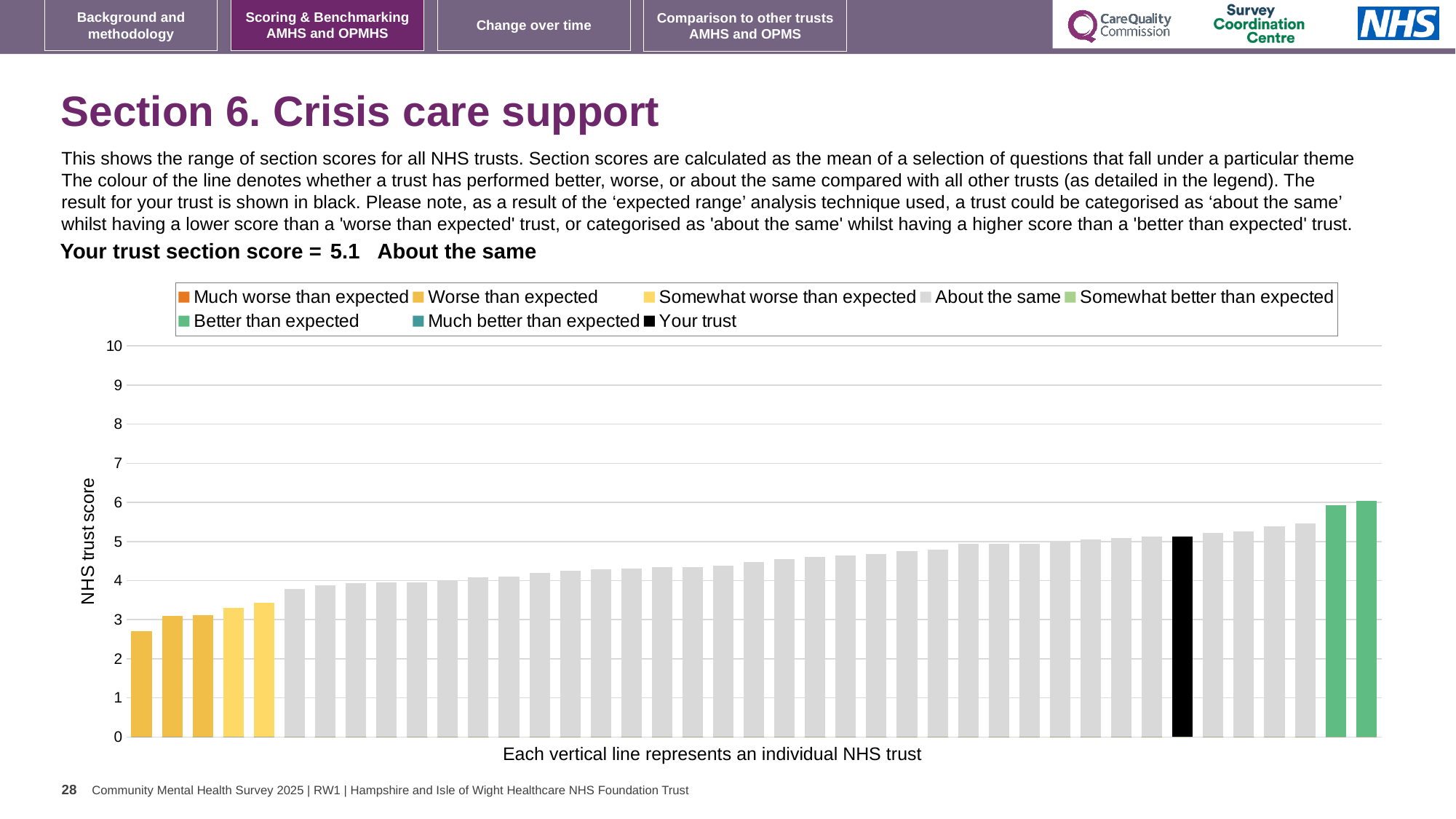
How many entries does the chart legend list? 8 What colour is the bar representing your trust? Black Do the bar values rise or fall from left to right along the x axis? rise What is the label on the y axis of the chart? NHS trust score Which category is your trust placed in for the Crisis care support section? About the same Is the value of the highest bar in the chart greater or less than 5? greater How many bars are coloured as 'Better than expected' (green)? 2 How many bars are coloured as 'Worse than expected' (darker yellow)? 3 Is the value of the lowest bar in the chart greater or less than 3? less What kind of chart is shown on the slide? Bar chart Which legend category does the highest bar in the chart belong to? Better than expected What is the section score for your trust shown on the slide? 5.1